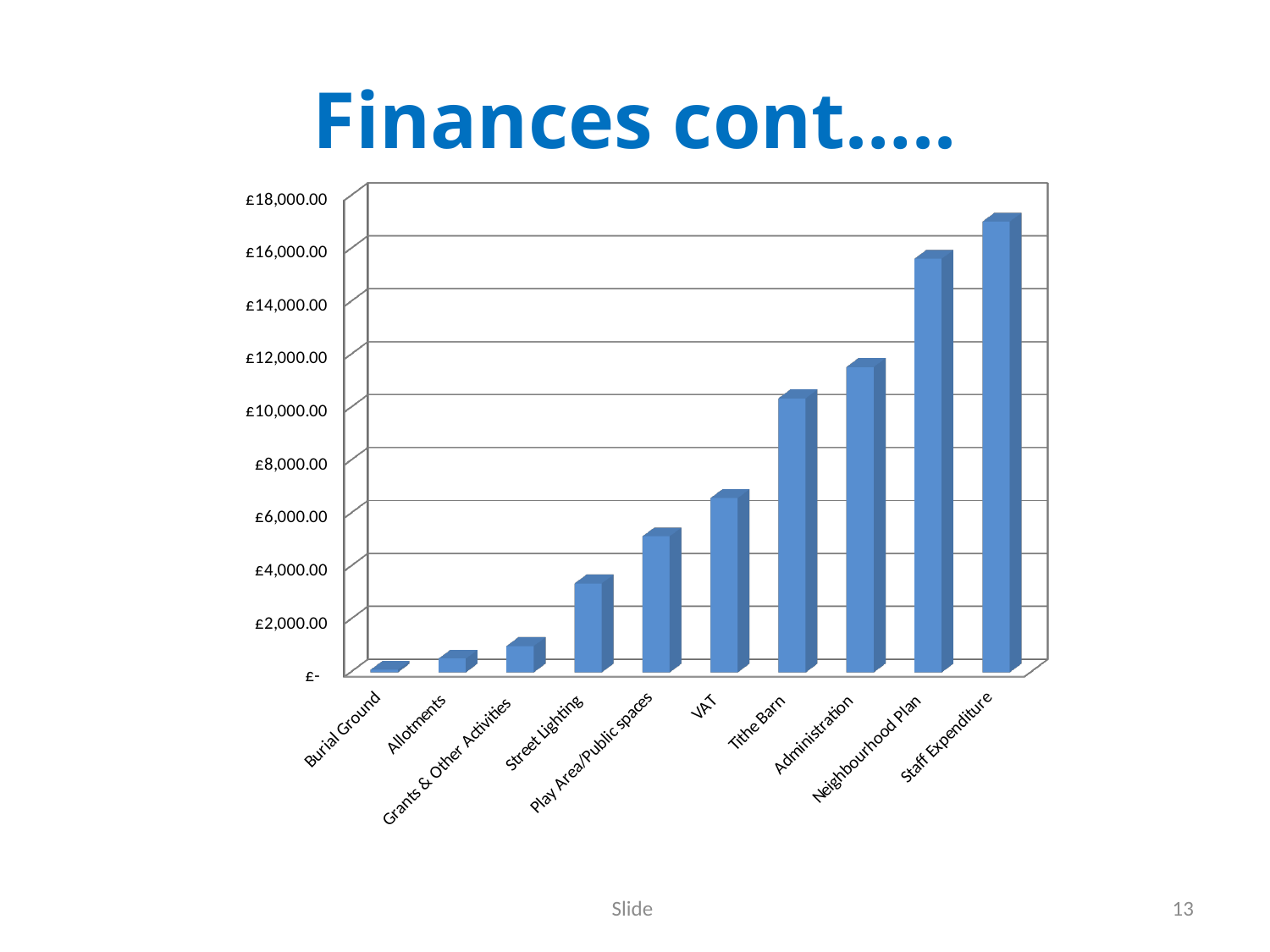
Is the value for VAT greater or less than £8,000.00? less Which category has the lowest value in the chart? Burial Ground Is the value for Tithe Barn greater or less than £8,000.00? greater What kind of chart is shown on the slide? bar chart Do the values rise or fall moving from left to right along the x axis? rise Is the value for Street Lighting greater or less than £4,000.00? less Which category has the highest value in the chart? Staff Expenditure Which is larger, the value for Neighbourhood Plan or the value for Administration? Neighbourhood Plan What is the title of the slide containing the chart? Finances cont….. How many categories are shown on the x axis of the chart? 10